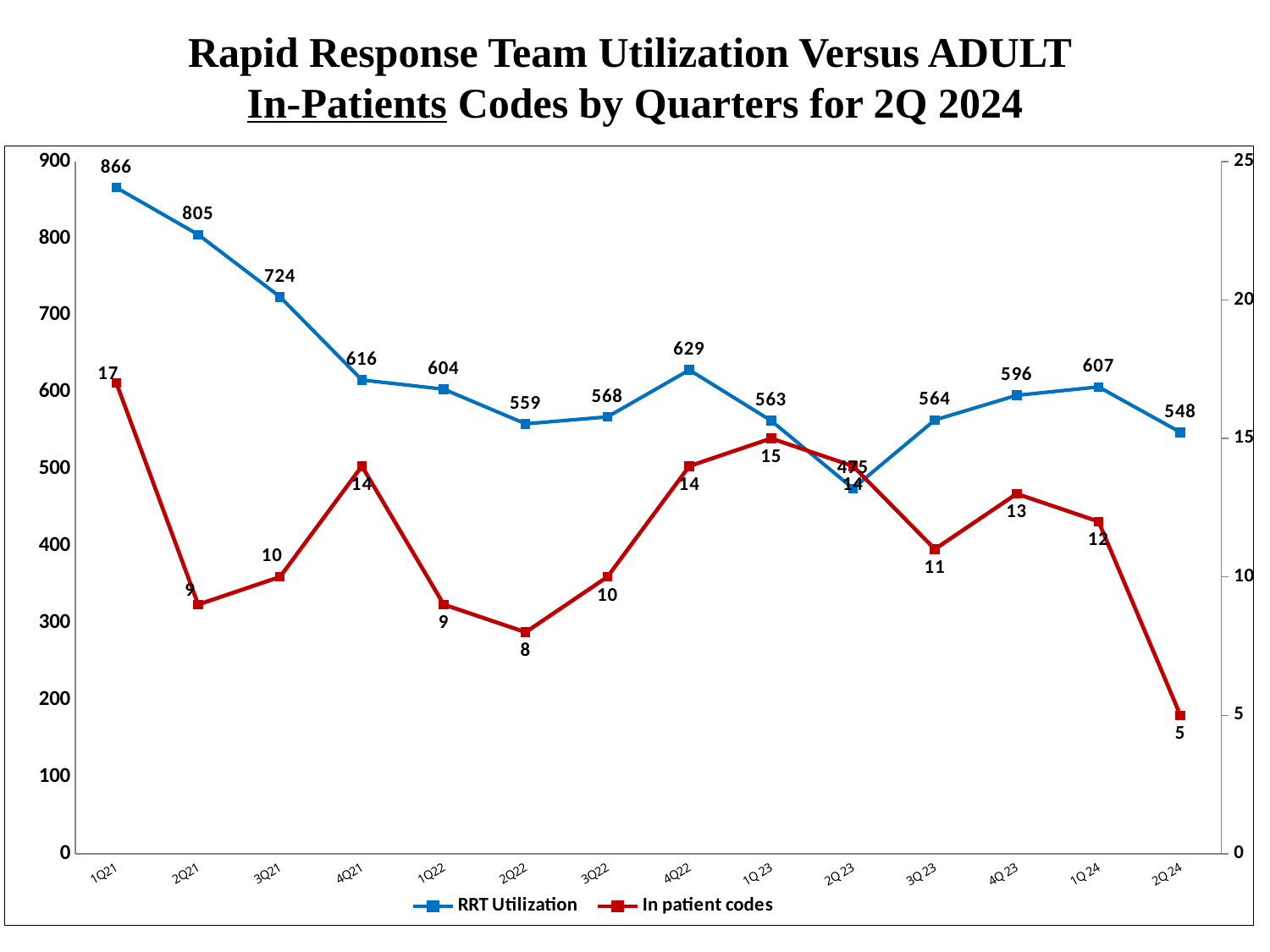
What is the In patient codes value for 2Q 24? 5 In which quarter is the In patient codes value lowest? 2Q 24 In which quarter is RRT Utilization highest? 1Q21 What is the RRT Utilization value for 2Q 23? 475 What is the RRT Utilization value for 1Q21? 866 Which quarter has a higher In patient codes value, 1Q 23 or 3Q 23? 1Q 23 What is the difference between RRT Utilization in 1Q21 and 2Q21? 61 How many quarters are plotted along the x axis? 14 What colour is the In patient codes line? red What type of chart is shown on the slide? line chart How many series does the legend list? 2 Does RRT Utilization rise or fall from 1Q21 to 4Q21? fall